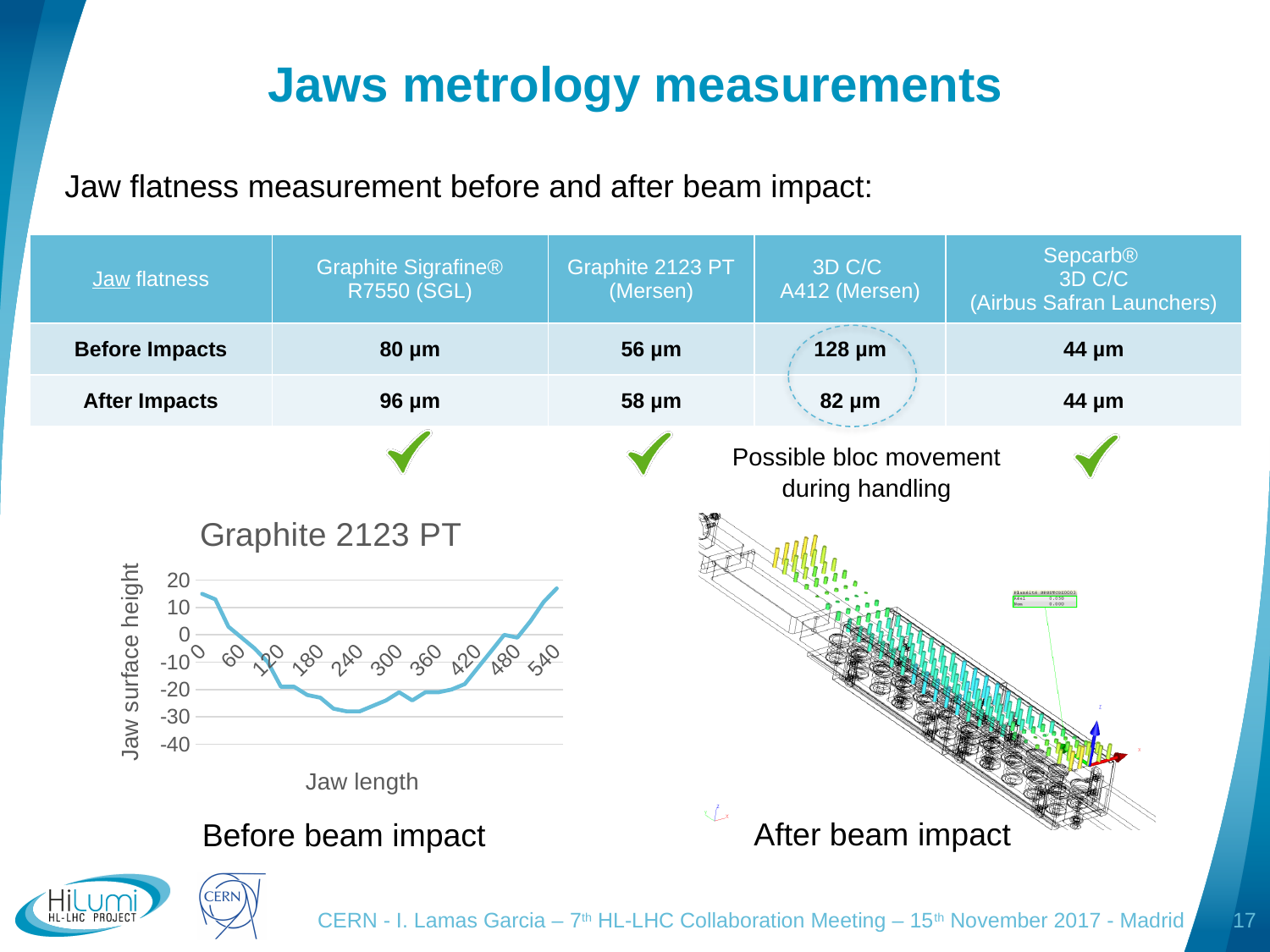
Is the jaw surface height at jaw length 540 greater or less than 10? greater Is the jaw surface height at jaw length 240 greater or less than -20? less Is the jaw surface height at jaw length 300 greater or less than -10? less Do the values rise or fall along the x axis between jaw length 0 and jaw length 240? fall Which is larger, the jaw surface height at jaw length 0 or at jaw length 240? jaw length 0 Which is larger, the jaw surface height at jaw length 120 or at jaw length 540? jaw length 540 What is the title of the chart on the slide? Graphite 2123 PT What is the label of the vertical axis of the chart? Jaw surface height Do the values rise or fall along the x axis between jaw length 360 and jaw length 540? rise What kind of chart is shown on the slide? line chart